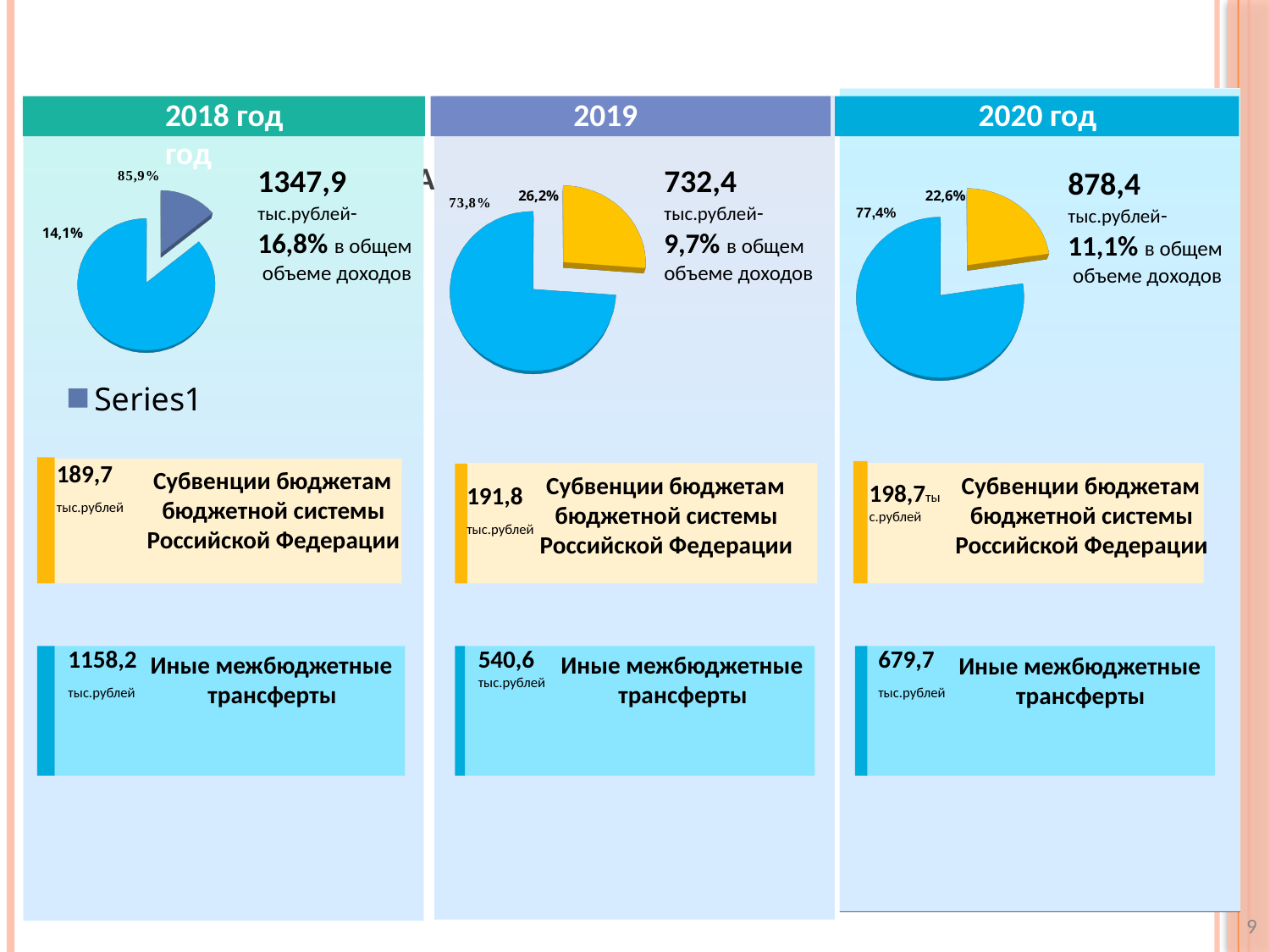
In the 2020 год pie chart, what percentage is shown for the smaller (exploded) slice? 22,6% How many slices does the 2019 pie chart have? 2 What type of chart is shown under the 2018 год heading? pie chart In the 2019 pie chart, what percentage is shown for the smaller (exploded) slice? 26,2% Which pie chart has the largest smaller slice: 2018 год, 2019, or 2020 год? 2019 In the 2020 год pie chart, what is the difference between the two slice percentages? 54,8% In the 2020 год pie chart, what percentage is shown for the larger slice? 77,4% In the 2019 pie chart, what percentage is shown for the larger slice? 73,8% In the 2018 год pie chart, what percentage is shown for the larger slice? 85,9% In the 2018 год pie chart, what percentage is shown for the smaller slice? 14,1% In the 2019 pie chart, is the smaller slice greater or less than 25%? greater What legend entry is shown below the 2018 год pie chart? Series1